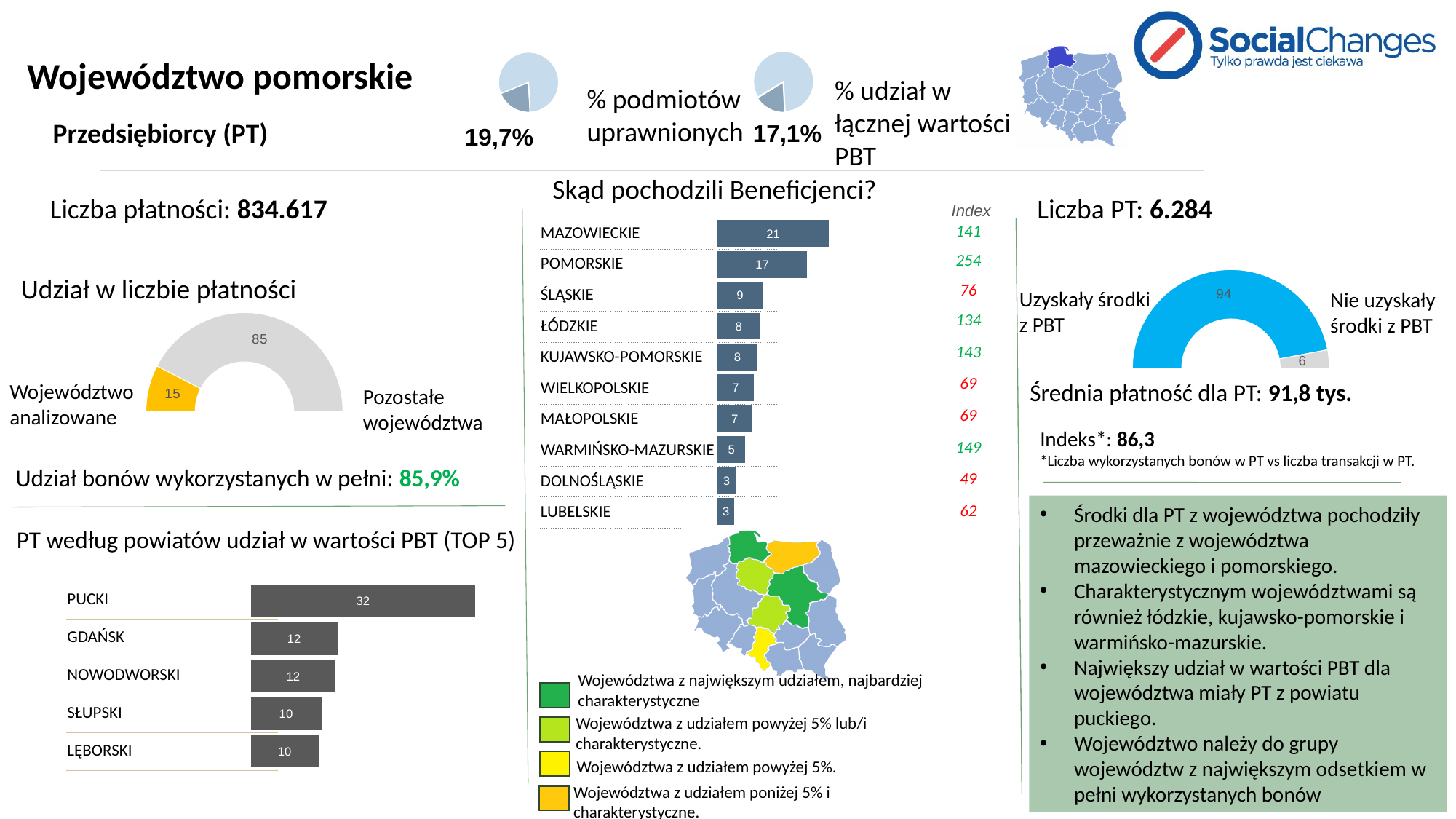
In the 'Skąd pochodzili Beneficjenci?' chart, what is the difference between the values for MAZOWIECKIE and POMORSKIE? 4 In the 'Skąd pochodzili Beneficjenci?' chart, how many voivodeships are listed? 10 In the 'PT według powiatów udział w wartości PBT (TOP 5)' chart, how many powiats are shown? 5 In the 'Skąd pochodzili Beneficjenci?' chart, which voivodeship has the highest value? MAZOWIECKIE In the doughnut chart next to 'Liczba PT', what is the value for 'Uzyskały środki z PBT'? 94 What kind of chart is 'PT według powiatów udział w wartości PBT (TOP 5)'? bar chart In the 'PT według powiatów udział w wartości PBT (TOP 5)' chart, what is the value for PUCKI? 32 In the 'Skąd pochodzili Beneficjenci?' chart, which is larger, the value for ŚLĄSKIE or the value for WIELKOPOLSKIE? ŚLĄSKIE In the 'PT według powiatów udział w wartości PBT (TOP 5)' chart, what is the difference between the values for PUCKI and GDAŃSK? 20 In the 'Skąd pochodzili Beneficjenci?' chart, what is the Index value shown for POMORSKIE? 254 In the 'Udział w liczbie płatności' chart, what is the value for 'Województwo analizowane'? 15 In the 'Skąd pochodzili Beneficjenci?' chart, what is the value for MAZOWIECKIE? 21